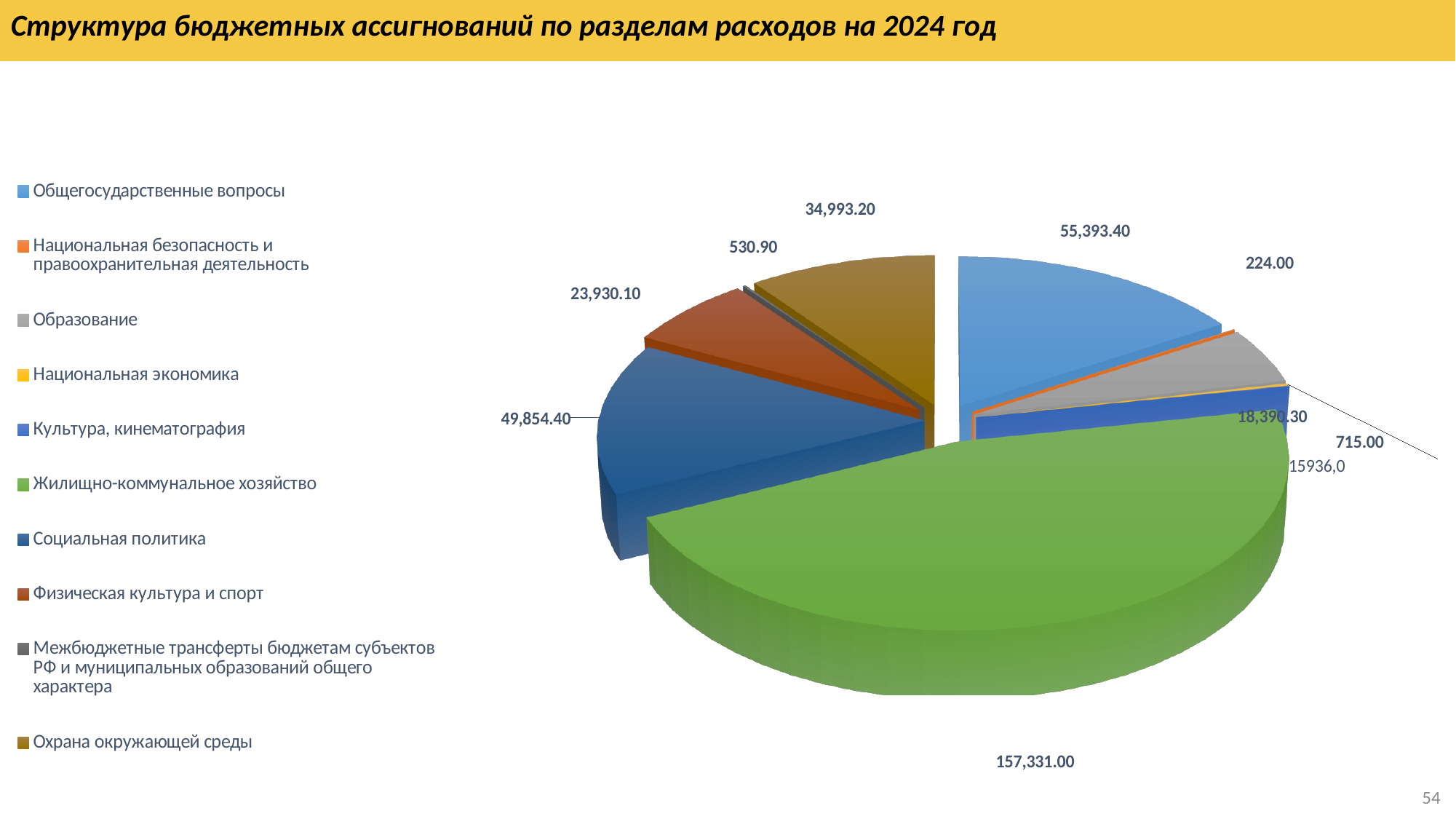
How many categories does the legend list? 10 Which is larger: Социальная политика or Физическая культура и спорт? Социальная политика What is the title of the slide? Структура бюджетных ассигнований по разделам расходов на 2024 год What kind of chart is shown on the slide? pie chart What is the value for Жилищно-коммунальное хозяйство? 157,331.00 What is the value for Охрана окружающей среды? 34,993.20 Which category has the smallest value? Национальная безопасность и правоохранительная деятельность What is the value for Социальная политика? 49,854.40 What is the value for Образование? 18,390.30 Which category has the largest slice of the pie? Жилищно-коммунальное хозяйство What is the value for Общегосударственные вопросы? 55,393.40 What is the difference between the values for Жилищно-коммунальное хозяйство and Общегосударственные вопросы? 101,937.60